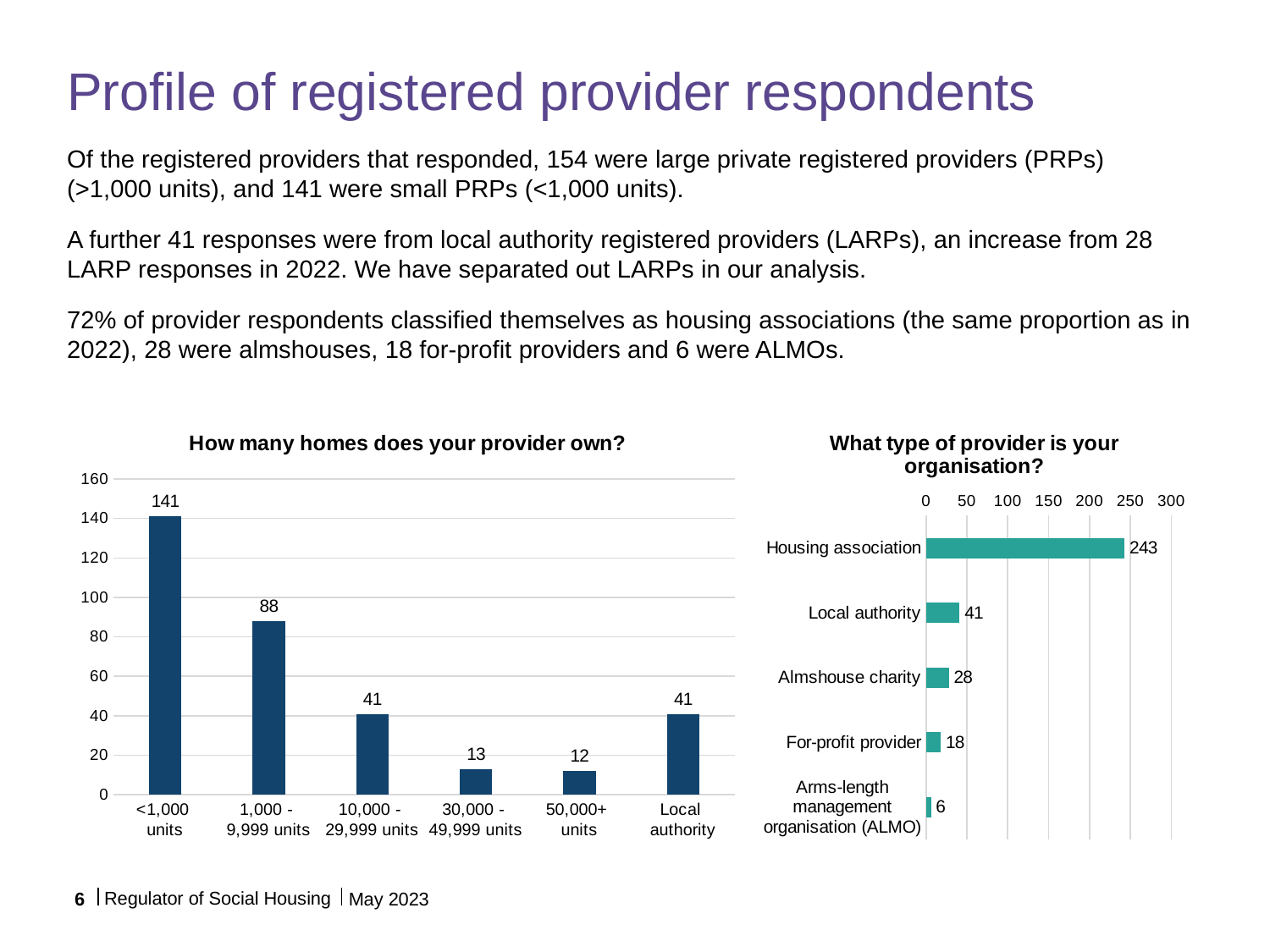
In the chart 'What type of provider is your organisation?', what is the value for 'Arms-length management organisation (ALMO)'? 6 What kind of chart is 'What type of provider is your organisation?'? Bar chart In the chart 'What type of provider is your organisation?', which is larger: 'Almshouse charity' or 'For-profit provider'? Almshouse charity In the chart 'How many homes does your provider own?', which category has the highest value? <1,000 units In the chart 'How many homes does your provider own?', how many categories are shown on the x axis? 6 In the chart 'How many homes does your provider own?', what is the difference between the values for '<1,000 units' and '1,000 - 9,999 units'? 53 In the chart 'How many homes does your provider own?', what is the value for '1,000 - 9,999 units'? 88 In the chart 'What type of provider is your organisation?', which category has the lowest value? Arms-length management organisation (ALMO) In the chart 'What type of provider is your organisation?', what is the difference between the values for 'Local authority' and 'Almshouse charity'? 13 In the chart 'How many homes does your provider own?', which category has the lowest value? 50,000+ units In the chart 'How many homes does your provider own?', what is the value for '<1,000 units'? 141 In the chart 'What type of provider is your organisation?', what is the value for 'Housing association'? 243